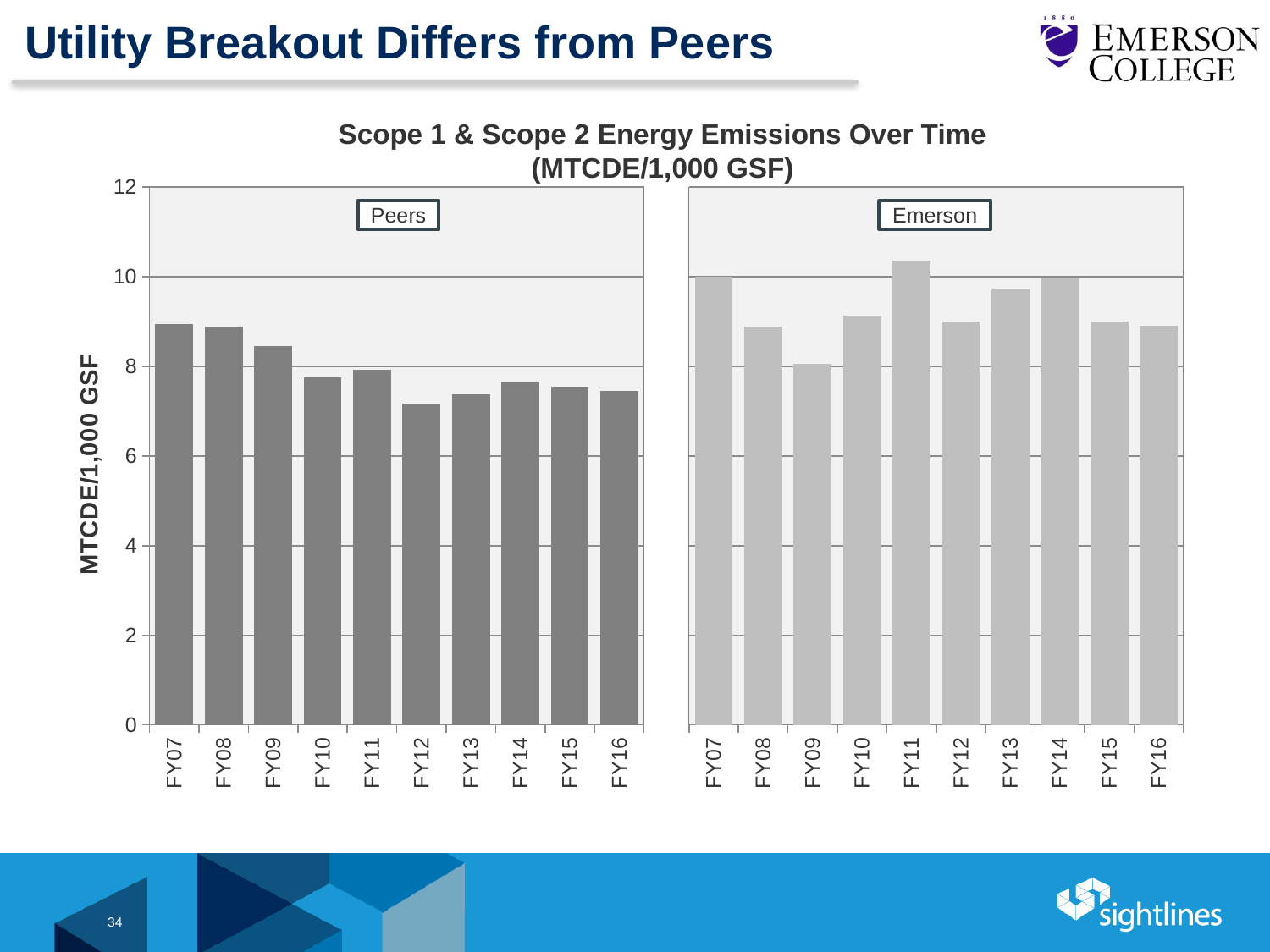
What kind of chart is shown on the slide? bar chart In the Peers panel, which fiscal year has the lowest emissions value? FY12 In the Peers panel, is the value for FY09 greater or less than 8? greater In the Emerson panel, which fiscal year has the lowest emissions value? FY09 In the Peers panel, is the value for FY12 greater or less than 8? less In the Emerson panel, is the value for FY13 greater or less than 10? less In the Peers panel, do the values generally rise or fall from FY07 to FY16? fall What is the label on the vertical axis of the chart? MTCDE/1,000 GSF How many fiscal years are plotted in the Peers panel? 10 For FY07, which is larger: the Peers value or the Emerson value? Emerson In the Emerson panel, which fiscal year has the highest emissions value? FY11